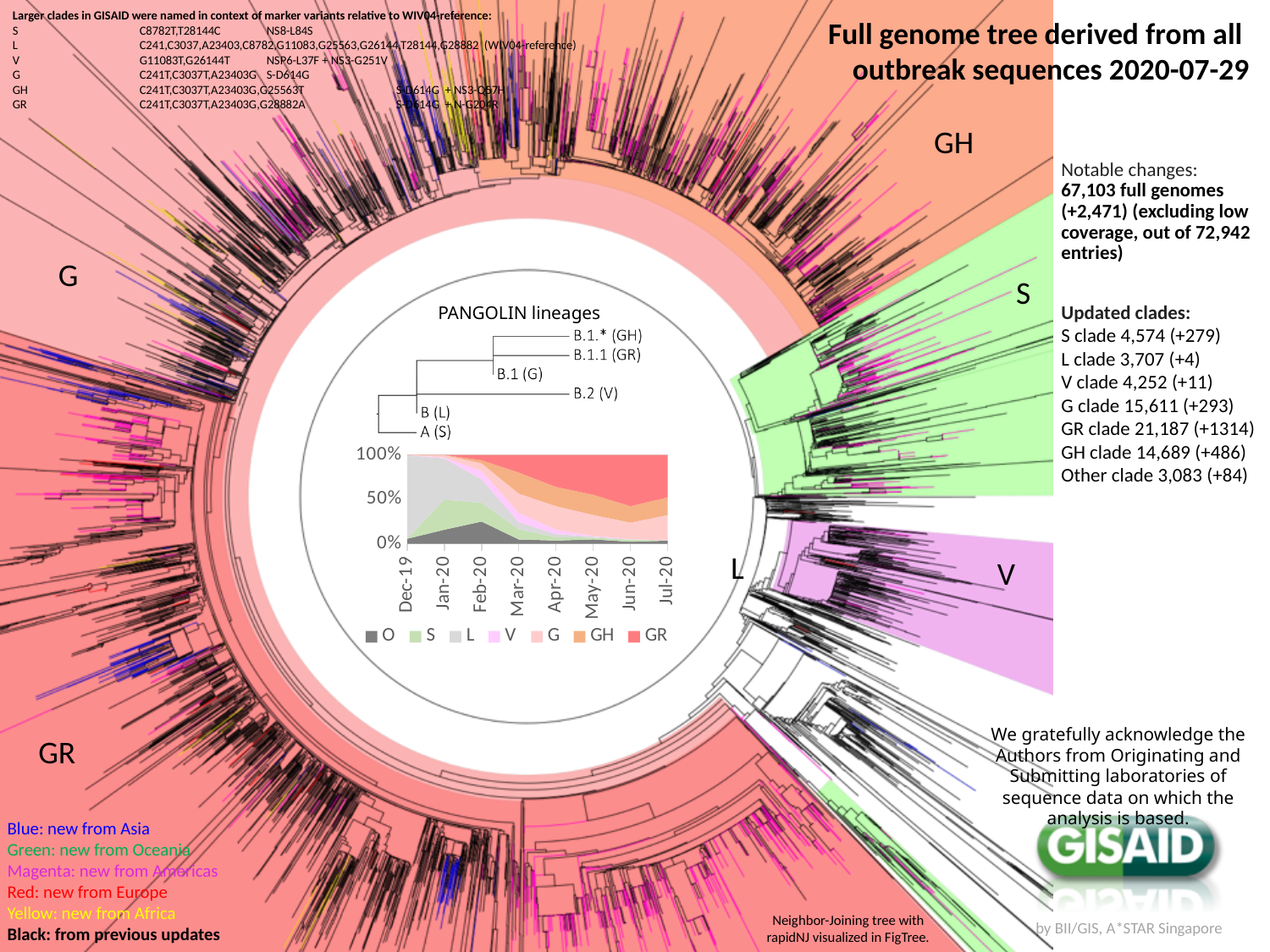
In the central stacked area chart, which is larger at Jul-20: the share of clade GR or the share of clade O? GR What is the last time point on the x axis of the central stacked area chart? Jul-20 What is the first time point on the x axis of the central stacked area chart? Dec-19 In the central stacked area chart, is the share of clade L at Dec-19 greater or less than 50%? greater In the central stacked area chart, which clade has the largest share at Dec-19? L How many series does the legend of the central stacked area chart list? 7 In the central stacked area chart, does the share of clade L rise or fall from Dec-19 to Jul-20? fall In the central stacked area chart, is the share of clade O at Jul-20 greater or less than 50%? less In the central stacked area chart, does the share of clade GR rise or fall from Dec-19 to Jul-20? rise In the central stacked area chart, which clade has the largest share at Jul-20? GR What kind of chart is the small chart in the centre of the slide showing clade proportions over time? stacked area chart How many time points are labelled on the x axis of the central stacked area chart? 8